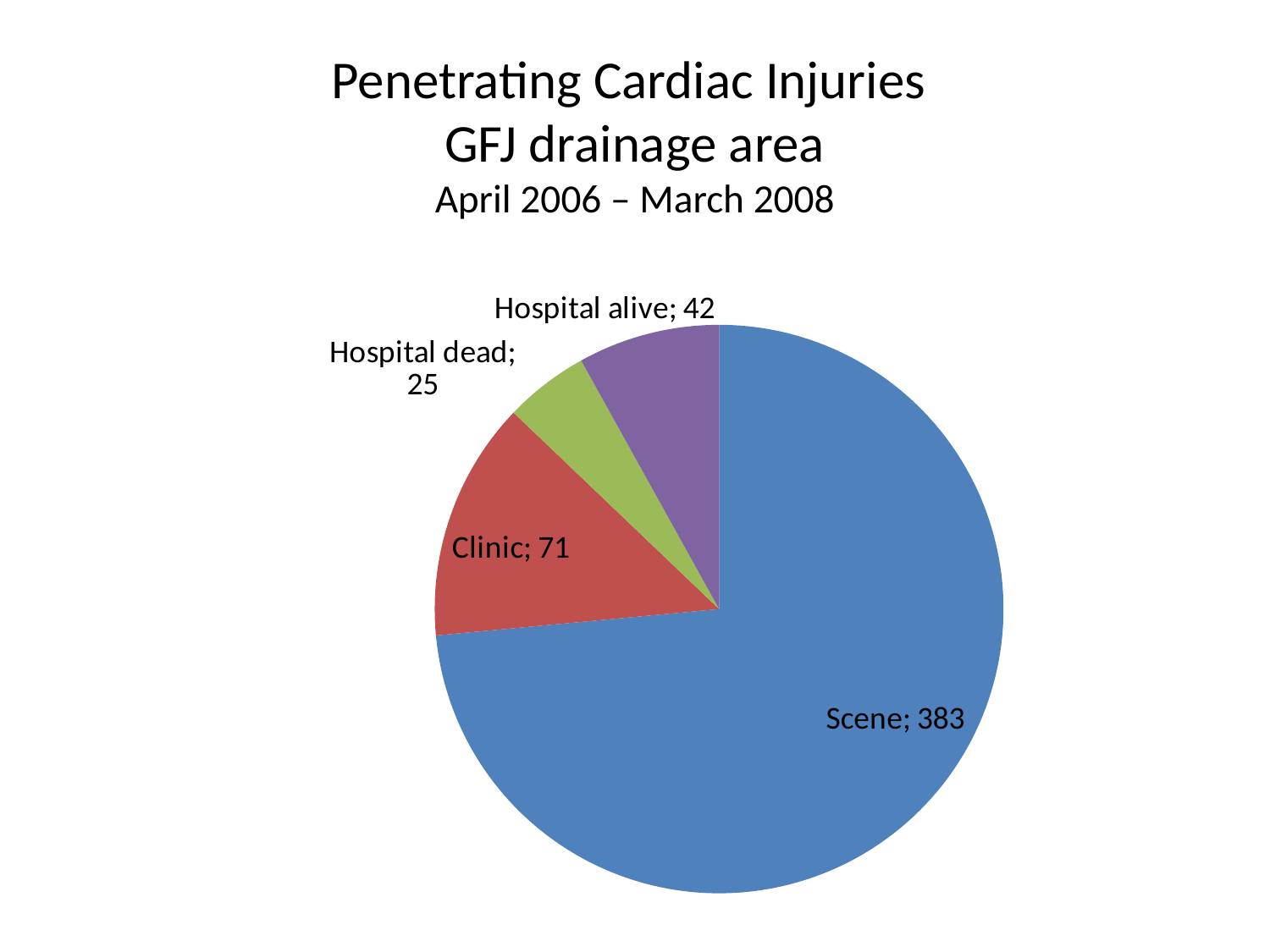
Which category has the largest slice? Scene What time period does the chart title cover? April 2006 – March 2008 How many slices does the pie chart have? 4 What is the total of all slices in the pie chart? 521 What kind of chart is shown on the slide? pie chart What is the value for Clinic? 71 What is the value for Hospital dead? 25 Which category has the smallest slice? Hospital dead What is the difference between the values for Scene and Clinic? 312 What is the value for Scene? 383 What is the value for Hospital alive? 42 Which is larger, Hospital alive or Hospital dead? Hospital alive